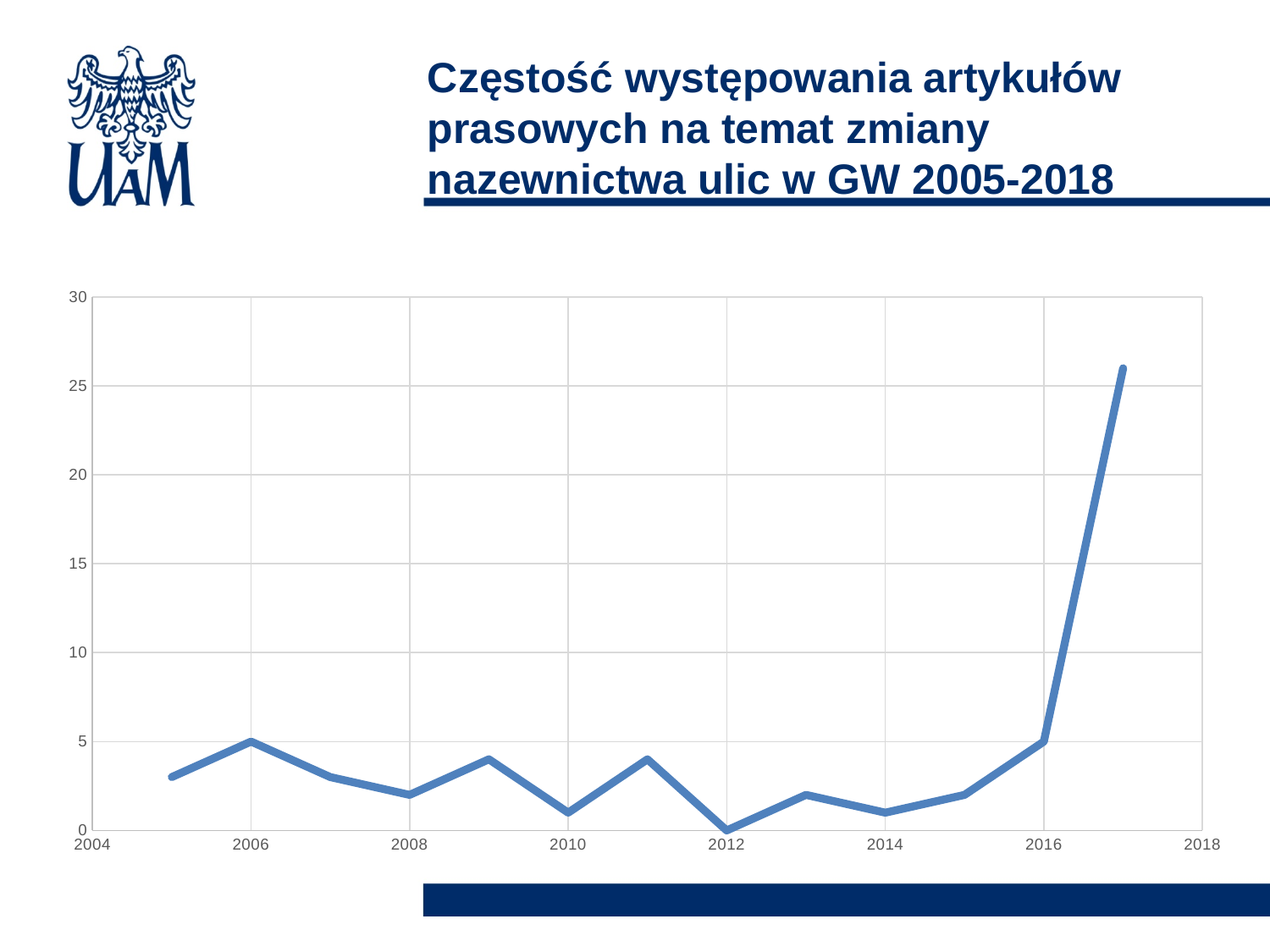
Is the value for 2017 greater or less than 20? greater What is the title of the chart on the slide? Częstość występowania artykułów prasowych na temat zmiany nazewnictwa ulic w GW 2005-2018 What is the difference between the value for 2016 and the value for 2012? 5 What is the value for 2006? 5 Does the value rise or fall between 2016 and 2017? rise What kind of chart is shown on the slide? line chart What is the value for 2012? 0 Which is larger, the value for 2017 or the value for 2006? 2017 Is the value for 2010 greater or less than 5? less In which year is the value lowest? 2012 What is the value for 2016? 5 In which year is the value highest? 2017